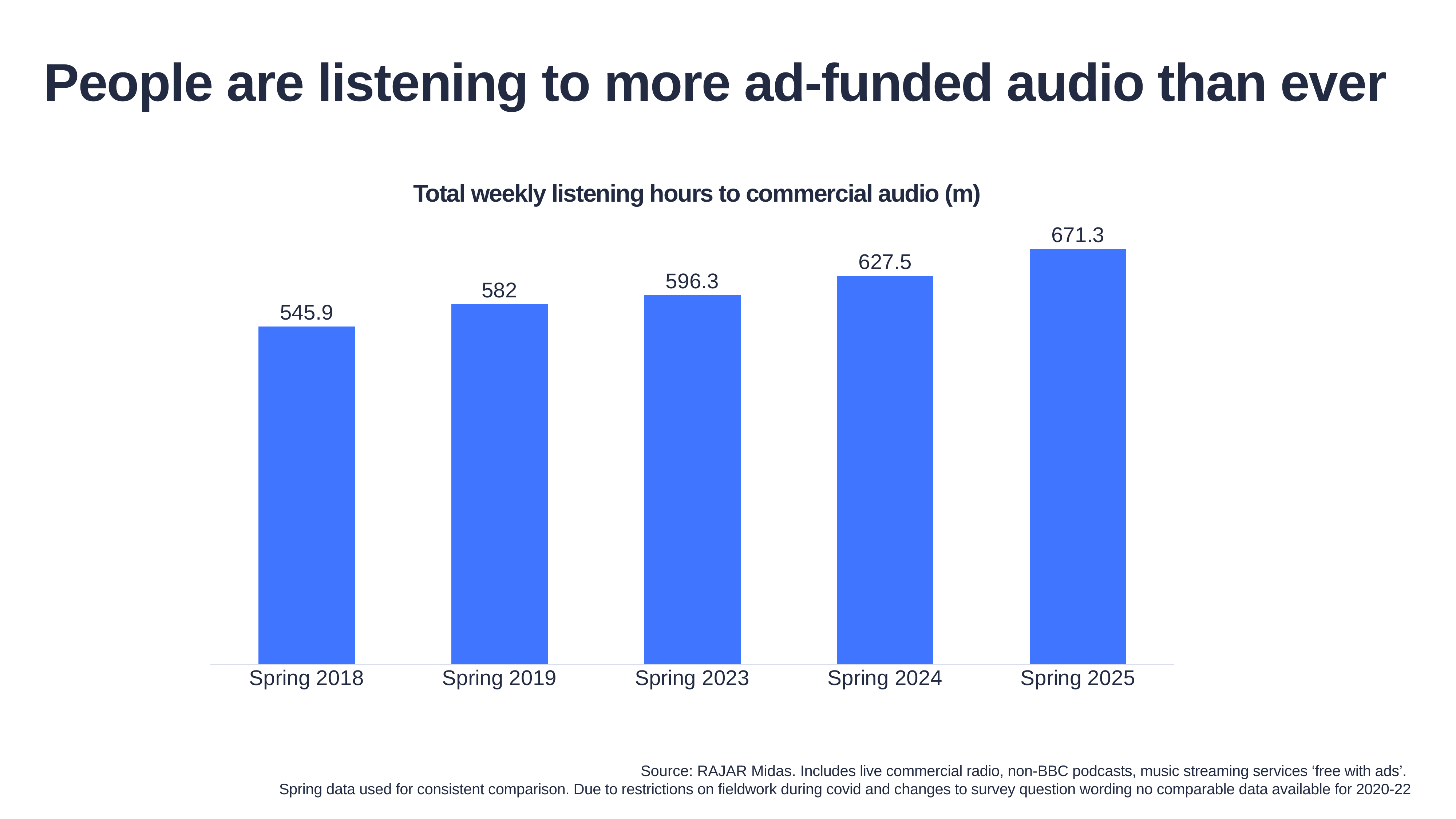
Which period has the lowest total weekly listening hours? Spring 2018 What is the value shown for Spring 2023? 596.3 Do the values rise or fall from Spring 2018 to Spring 2025? Rise What kind of chart is shown on the slide? Bar chart What is the difference between the Spring 2025 and Spring 2018 values? 125.4 Which is larger, the value for Spring 2019 or Spring 2024? Spring 2024 What is the title of the chart? Total weekly listening hours to commercial audio (m) What is the total weekly listening hours to commercial audio (m) for Spring 2018? 545.9 What is the difference between the Spring 2024 and Spring 2023 values? 31.2 Which period has the highest total weekly listening hours? Spring 2025 What is the value shown for Spring 2025? 671.3 How many periods are shown on the chart? 5